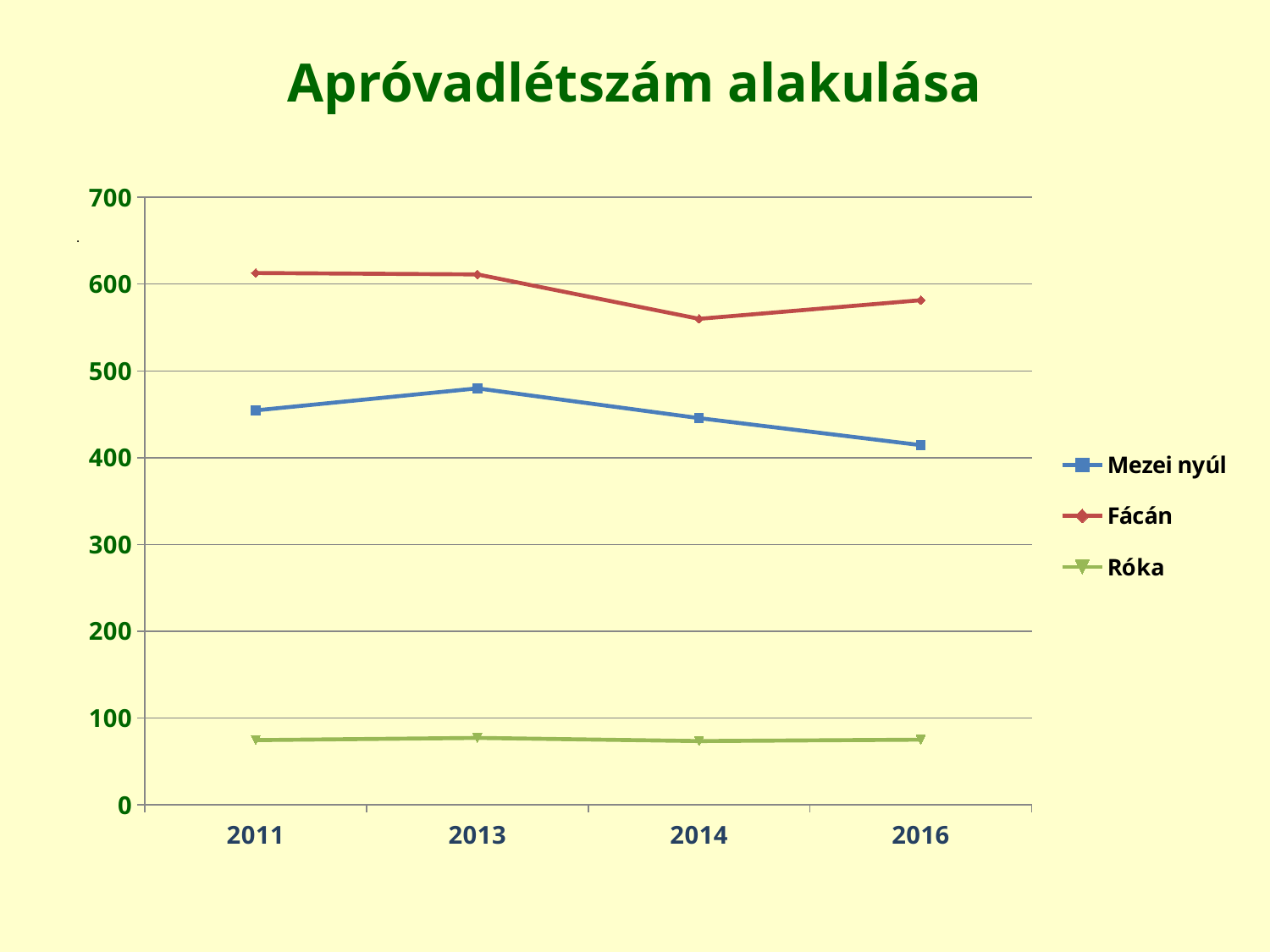
Is the value for Mezei nyúl in 2016 greater or less than 400? greater Is the value for Fácán in 2014 greater or less than 600? less How many years are plotted along the x axis? 4 Which series has the lowest values across all years? Róka How many series does the legend list? 3 In which year is the value for Mezei nyúl lowest? 2016 What is the title of the chart? Apróvadlétszám alakulása What kind of chart is shown on the slide? line chart In which year is the value for Fácán lowest? 2014 In which year is the value for Mezei nyúl highest? 2013 Which series has the highest values across all years? Fácán Does the value for Mezei nyúl rise or fall from 2013 to 2016? fall